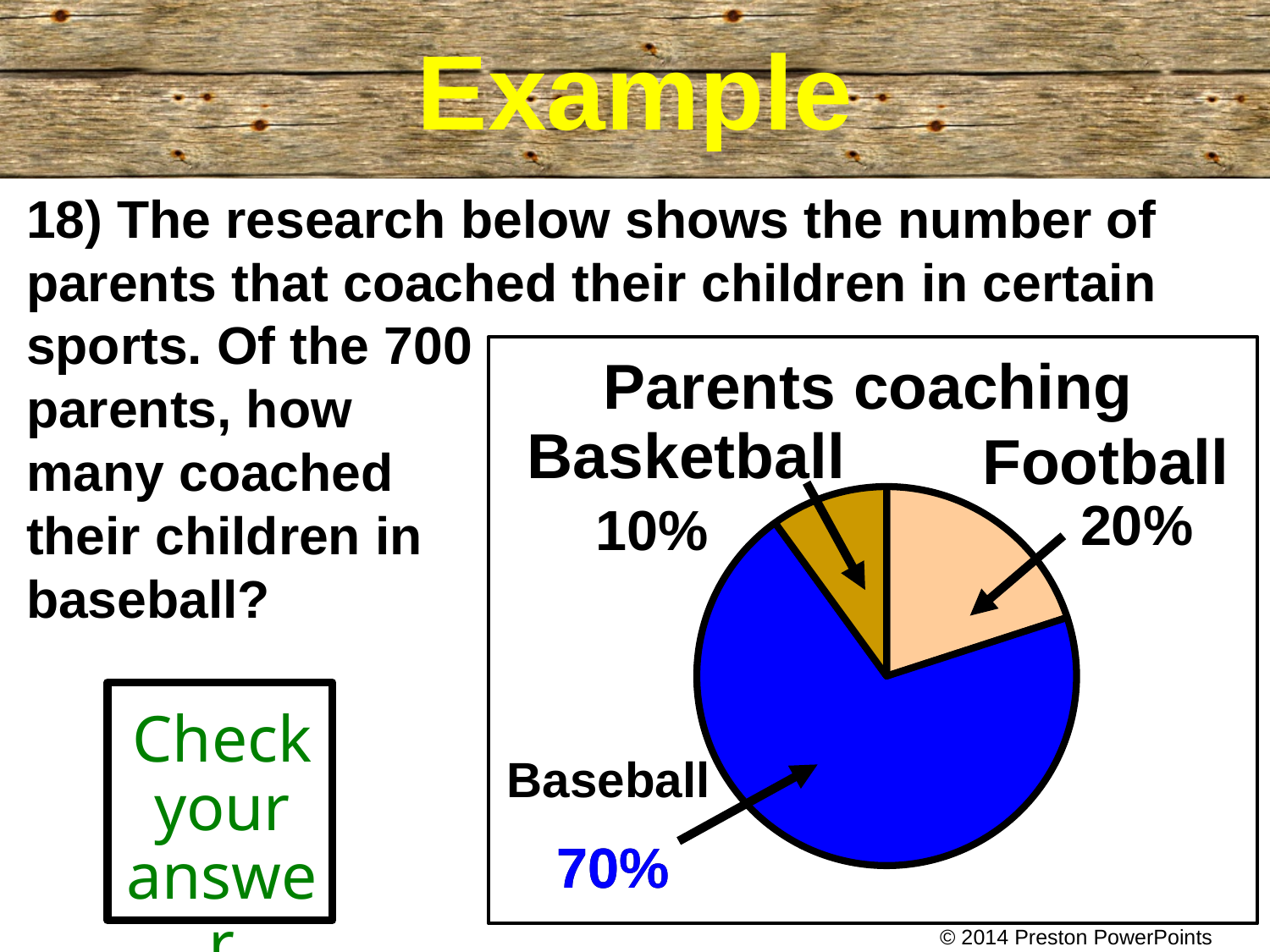
What is the title of the chart? Parents coaching Which slice is larger, football or basketball? Football What kind of chart is shown on the slide? pie chart Which sport has the smallest slice of the pie? Basketball What percentage of parents coached baseball? 70% What is the combined share of the football and basketball slices? 30% What percentage of parents coached football? 20% Which sport has the largest slice of the pie? Baseball What colour is the baseball slice? blue What is the difference in percentage points between the baseball and football slices? 50 How many slices does the pie chart have? 3 What percentage of parents coached basketball? 10%